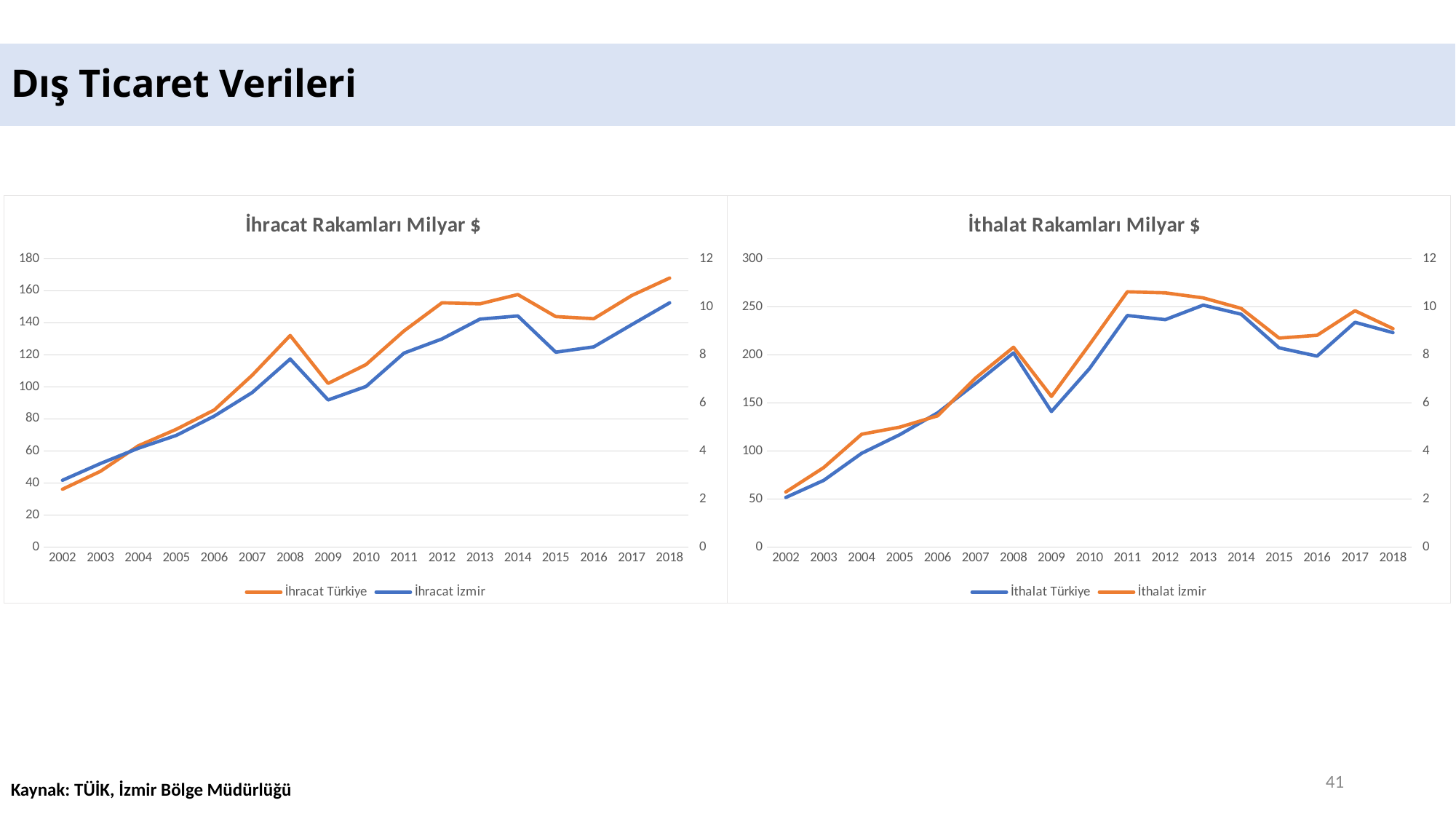
In the 'İhracat Rakamları Milyar $' chart, which year has the lowest value for İhracat Türkiye? 2002 In the 'İhracat Rakamları Milyar $' chart, does İhracat Türkiye rise or fall from 2008 to 2009? fall In the 'İhracat Rakamları Milyar $' chart, is İhracat Türkiye higher in 2014 or in 2015? 2014 In the 'İthalat Rakamları Milyar $' chart, which series is drawn in orange? İthalat İzmir How many series does the legend of the 'İthalat Rakamları Milyar $' chart list? 2 In the 'İhracat Rakamları Milyar $' chart, is the value for İhracat Türkiye in 2018 (left axis) greater or less than 160? greater How many years are shown on the x axis of the 'İhracat Rakamları Milyar $' chart? 17 In the 'İthalat Rakamları Milyar $' chart, is the value for İthalat Türkiye in 2009 (left axis) greater or less than 150? less In the 'İthalat Rakamları Milyar $' chart, which year has the highest value for İthalat Türkiye? 2013 What kind of chart is the 'İhracat Rakamları Milyar $' chart? line chart In the 'İhracat Rakamları Milyar $' chart, is the value for İhracat Türkiye in 2008 (left axis) greater or less than 120? greater In the 'İhracat Rakamları Milyar $' chart, which year has the highest value for İhracat Türkiye? 2018